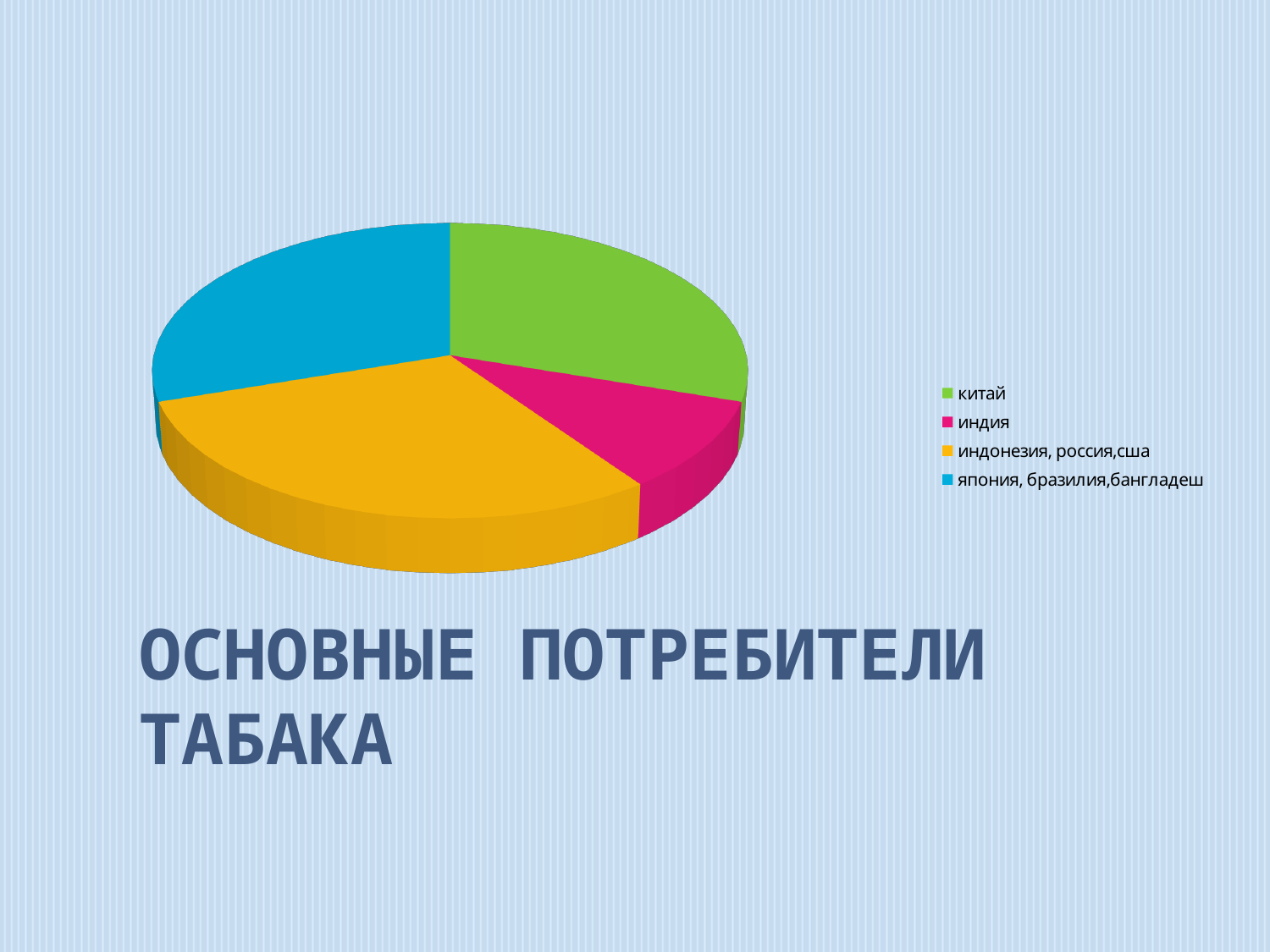
Which slice is larger: япония, бразилия,бангладеш or индия? япония, бразилия,бангладеш Which category is shown in blue? япония, бразилия,бангладеш Which category has the smallest slice of the pie? индия How many entries does the legend list? 4 What colour is the slice for китай? green How many slices does the pie chart have? 4 Which slice is larger: индонезия, россия,сша or индия? индонезия, россия,сша What kind of chart is shown on the slide? pie chart Which slice is larger: китай or индия? китай